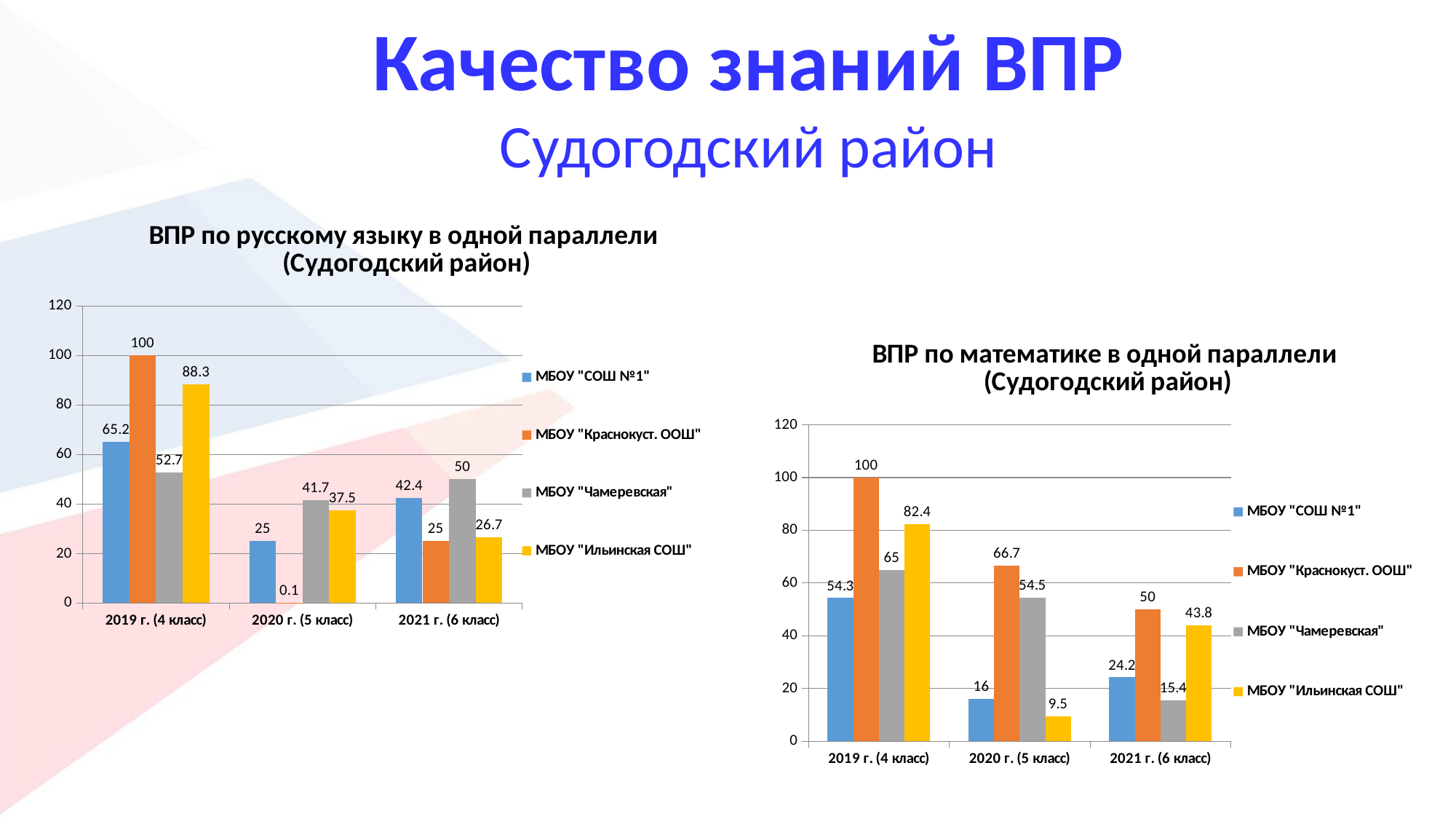
What type of chart is "ВПР по математике в одной параллели (Судогодский район)"? bar chart How many series does the legend of the chart "ВПР по математике в одной параллели (Судогодский район)" list? 4 In the chart "ВПР по русскому языку в одной параллели (Судогодский район)", which school has the lowest value in 2021 г. (6 класс)? МБОУ "Краснокуст. ООШ" In the chart "ВПР по математике в одной параллели (Судогодский район)", what is the difference between МБОУ "Краснокуст. ООШ" and МБОУ "Ильинская СОШ" in 2019 г. (4 класс)? 17.6 In the chart "ВПР по математике в одной параллели (Судогодский район)", is the value for МБОУ "СОШ №1" in 2021 г. (6 класс) greater or less than 40? less In the chart "ВПР по русскому языку в одной параллели (Судогодский район)", which is larger in 2020 г. (5 класс): МБОУ "Чамеревская" or МБОУ "Ильинская СОШ"? МБОУ "Чамеревская" In the chart "ВПР по математике в одной параллели (Судогодский район)", does the value for МБОУ "СОШ №1" rise or fall from 2019 г. (4 класс) to 2020 г. (5 класс)? fall In the chart "ВПР по русскому языку в одной параллели (Судогодский район)", what is the value for МБОУ "Ильинская СОШ" in 2019 г. (4 класс)? 88.3 How many categories are shown on the x axis of the chart "ВПР по русскому языку в одной параллели (Судогодский район)"? 3 In the chart "ВПР по русскому языку в одной параллели (Судогодский район)", what is the value for МБОУ "Краснокуст. ООШ" in 2020 г. (5 класс)? 0.1 In the chart "ВПР по математике в одной параллели (Судогодский район)", what is the value for МБОУ "Чамеревская" in 2021 г. (6 класс)? 15.4 In the chart "ВПР по математике в одной параллели (Судогодский район)", which school has the highest value in 2020 г. (5 класс)? МБОУ "Краснокуст. ООШ"